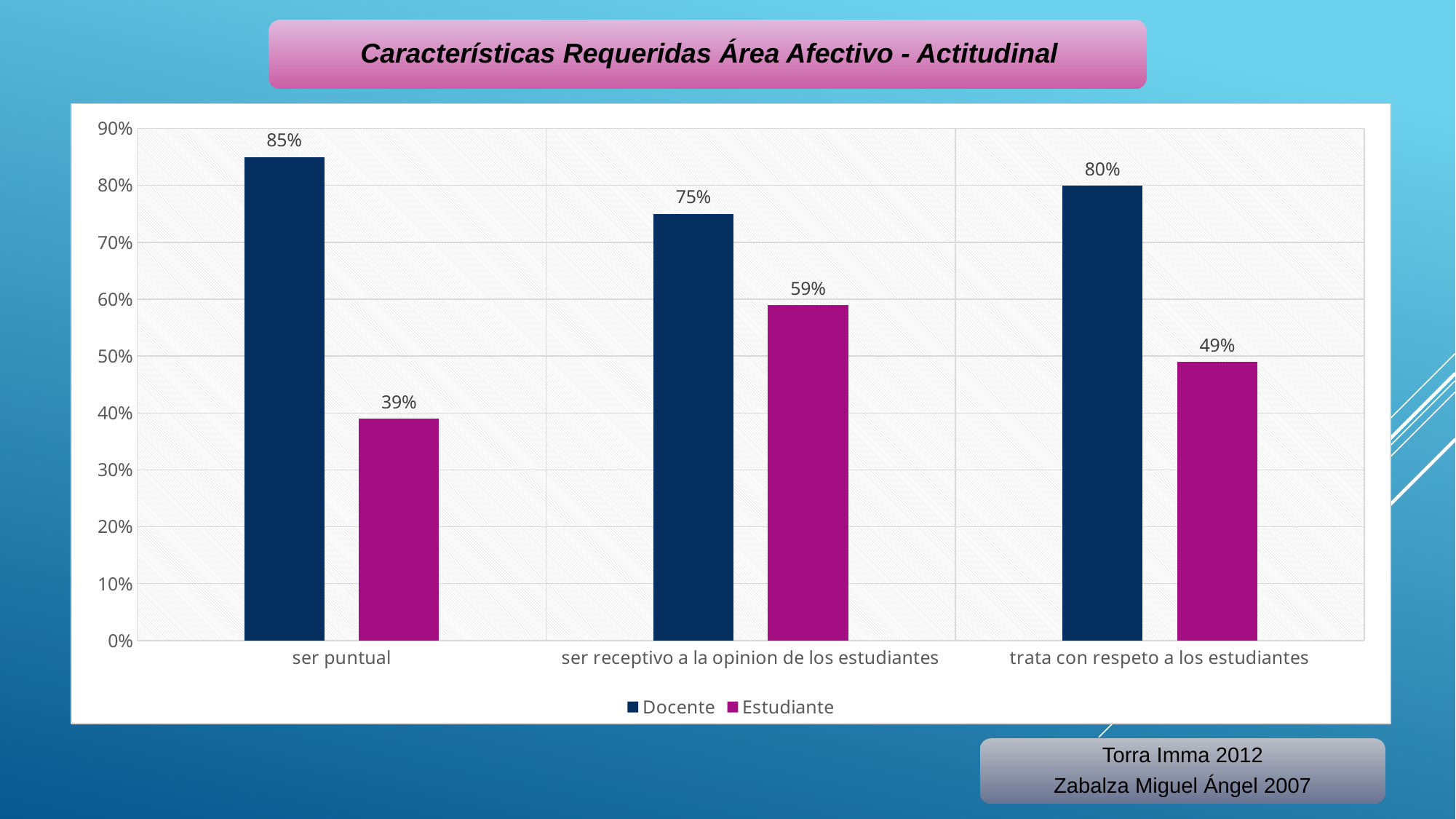
Which category has the lowest Estudiante value? ser puntual What is the Estudiante value for "trata con respeto a los estudiantes"? 49% What is the title of the slide above the chart? Características Requeridas Área Afectivo - Actitudinal What is the difference between the Docente values for "ser puntual" and "trata con respeto a los estudiantes"? 5% What kind of chart is shown on the slide? bar chart How many series does the legend list? 2 Which is larger: the Estudiante value for "ser receptivo a la opinion de los estudiantes" or the Estudiante value for "trata con respeto a los estudiantes"? ser receptivo a la opinion de los estudiantes What is the Estudiante value for "ser receptivo a la opinion de los estudiantes"? 59% Which category has the highest Docente value? ser puntual How many categories are shown on the x axis? 3 What is the Docente value for "ser puntual"? 85% What is the difference between the Docente and Estudiante values for "ser puntual"? 46%